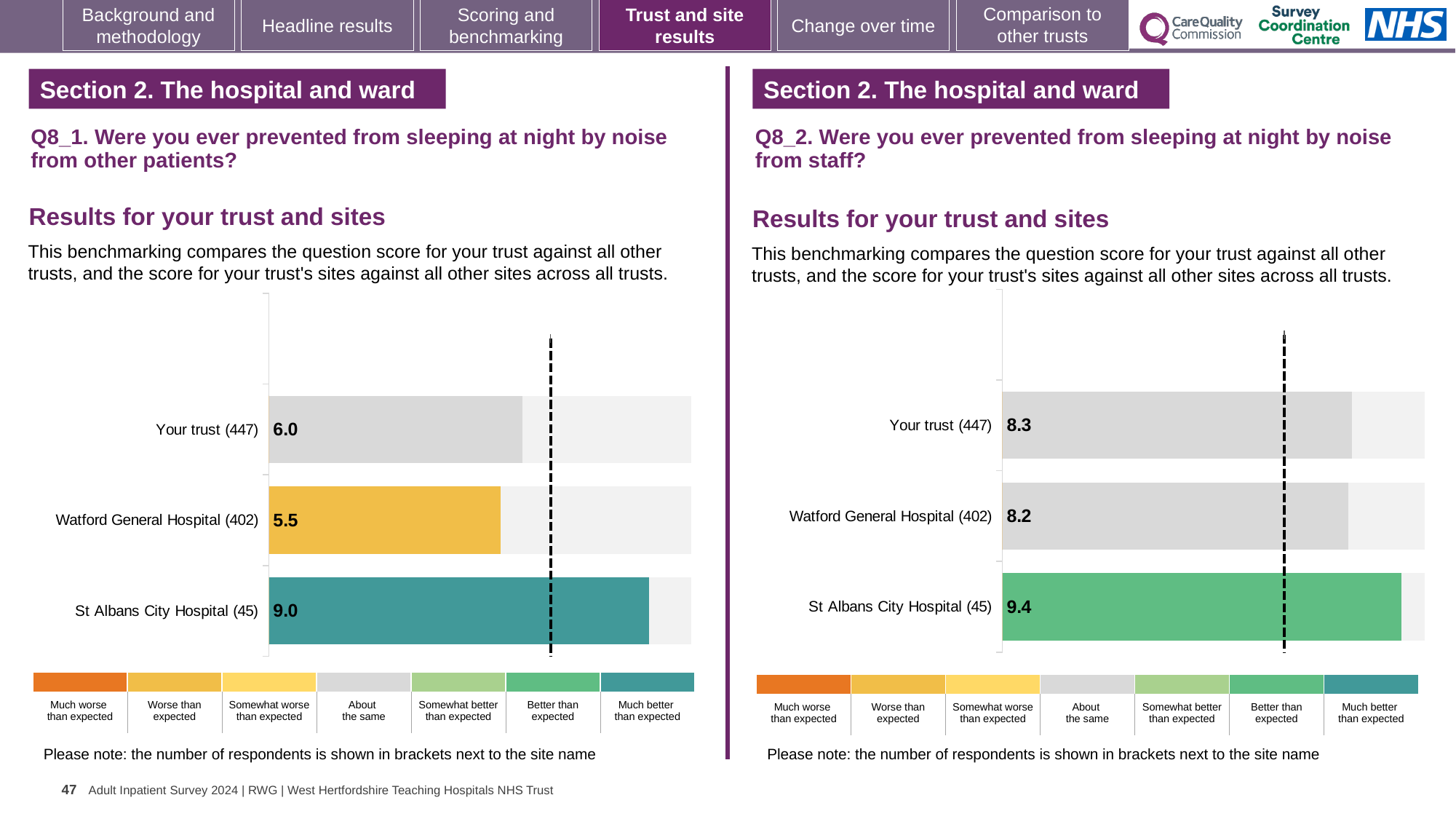
How many bars are plotted in the Q8_1 chart (noise from other patients)? 3 In the Q8_1 chart (noise from other patients), what is the score for Watford General Hospital (402)? 5.5 In the Q8_2 chart (noise from staff), what is the score for Your trust (447)? 8.3 In the Q8_2 chart (noise from staff), what is the difference between the scores for St Albans City Hospital and Your trust? 1.1 In the Q8_2 chart (noise from staff), which site or trust has the lowest score? Watford General Hospital (402) What type of chart is used in the Q8_2 chart (noise from staff)? Bar chart In the Q8_1 chart (noise from other patients), which site or trust has the highest score? St Albans City Hospital (45) In the Q8_1 chart (noise from other patients), what is the difference between the scores for St Albans City Hospital and Watford General Hospital? 3.5 In the Q8_1 chart (noise from other patients), which site or trust has the lowest score? Watford General Hospital (402) In the Q8_1 chart (noise from other patients), what is the score for Your trust (447)? 6.0 In the Q8_2 chart (noise from staff), what is the score for St Albans City Hospital (45)? 9.4 Which is larger: the Watford General Hospital score in the Q8_1 chart or the Watford General Hospital score in the Q8_2 chart? Q8_2 chart (8.2)